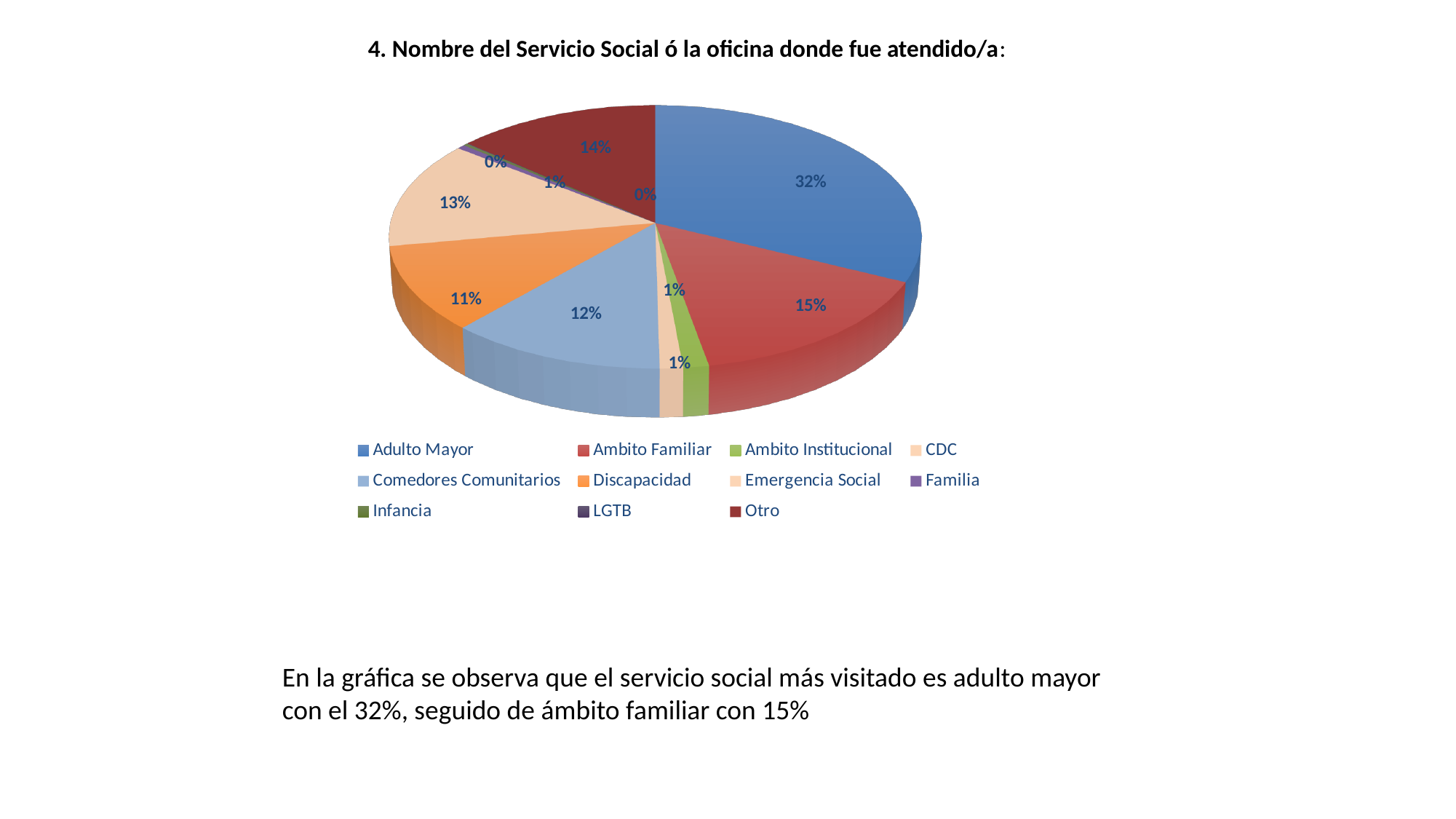
What is the value shown for Discapacidad? 11% What share of the pie does Adulto Mayor have? 32% What is the value shown for Comedores Comunitarios? 12% What kind of chart is shown on the slide? pie chart Which is larger, Otro or Emergencia Social? Otro How many categories does the legend list? 11 Which category has the largest slice of the pie? Adulto Mayor What is the title of the chart? 4. Nombre del Servicio Social ó la oficina donde fue atendido/a: What is the difference in percentage points between Adulto Mayor and Ambito Familiar? 17 What is the value shown for Otro? 14% What is the value shown for Emergencia Social? 13% What is the value shown for Ambito Familiar? 15%